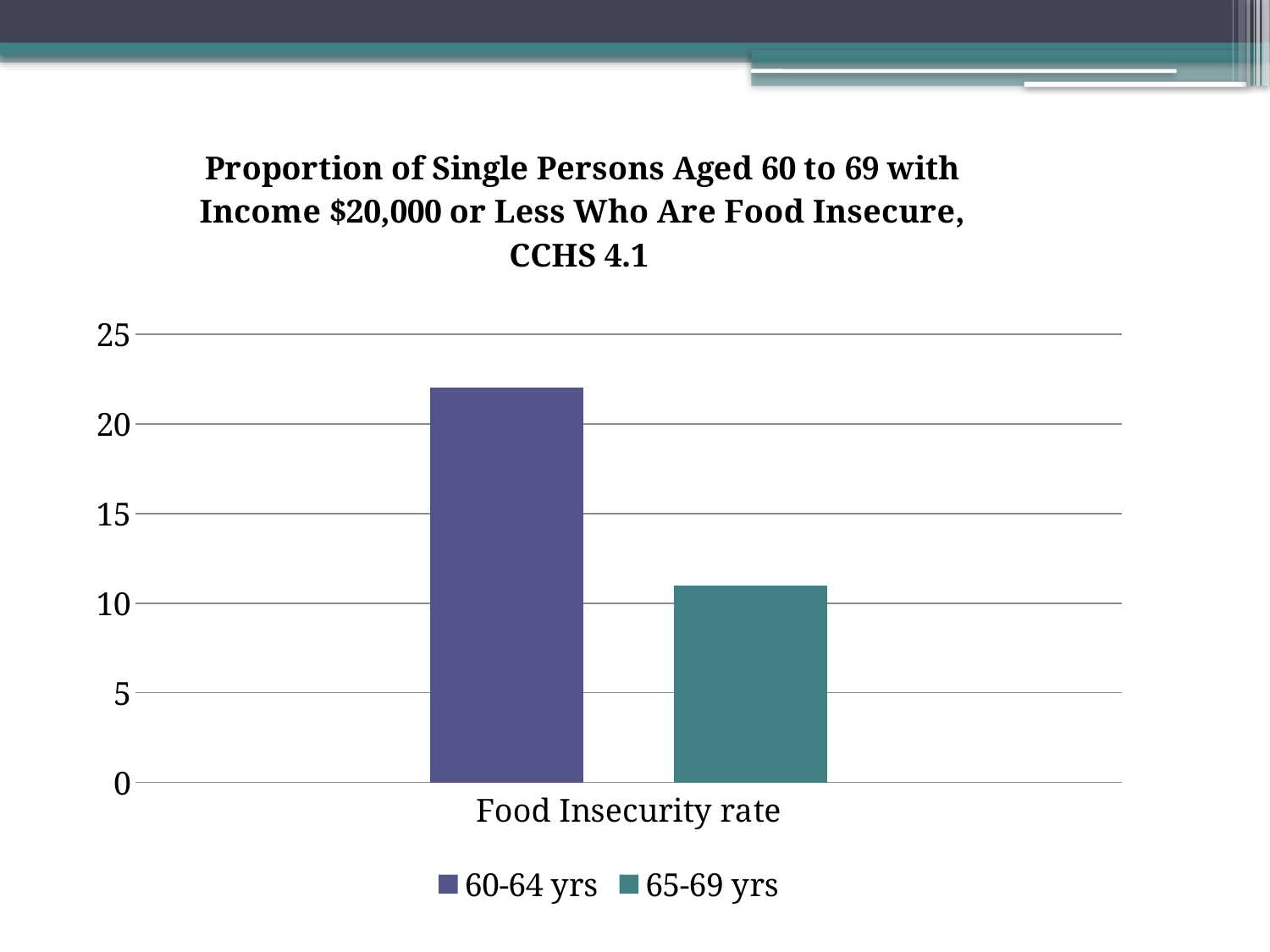
Which is larger, the food insecurity rate for 60-64 yrs or for 65-69 yrs? 60-64 yrs How many series does the legend list? 2 Is the food insecurity rate for 65-69 yrs greater or less than 15? less Is the food insecurity rate for 65-69 yrs greater or less than 10? greater How many bars are plotted on the chart? 2 Is the food insecurity rate for 60-64 yrs greater or less than 25? less Which age group has the higher food insecurity rate? 60-64 yrs What kind of chart is shown on the slide? bar chart What is the label on the x axis category? Food Insecurity rate Which age group has the lower food insecurity rate? 65-69 yrs Which survey is named in the chart title? CCHS 4.1